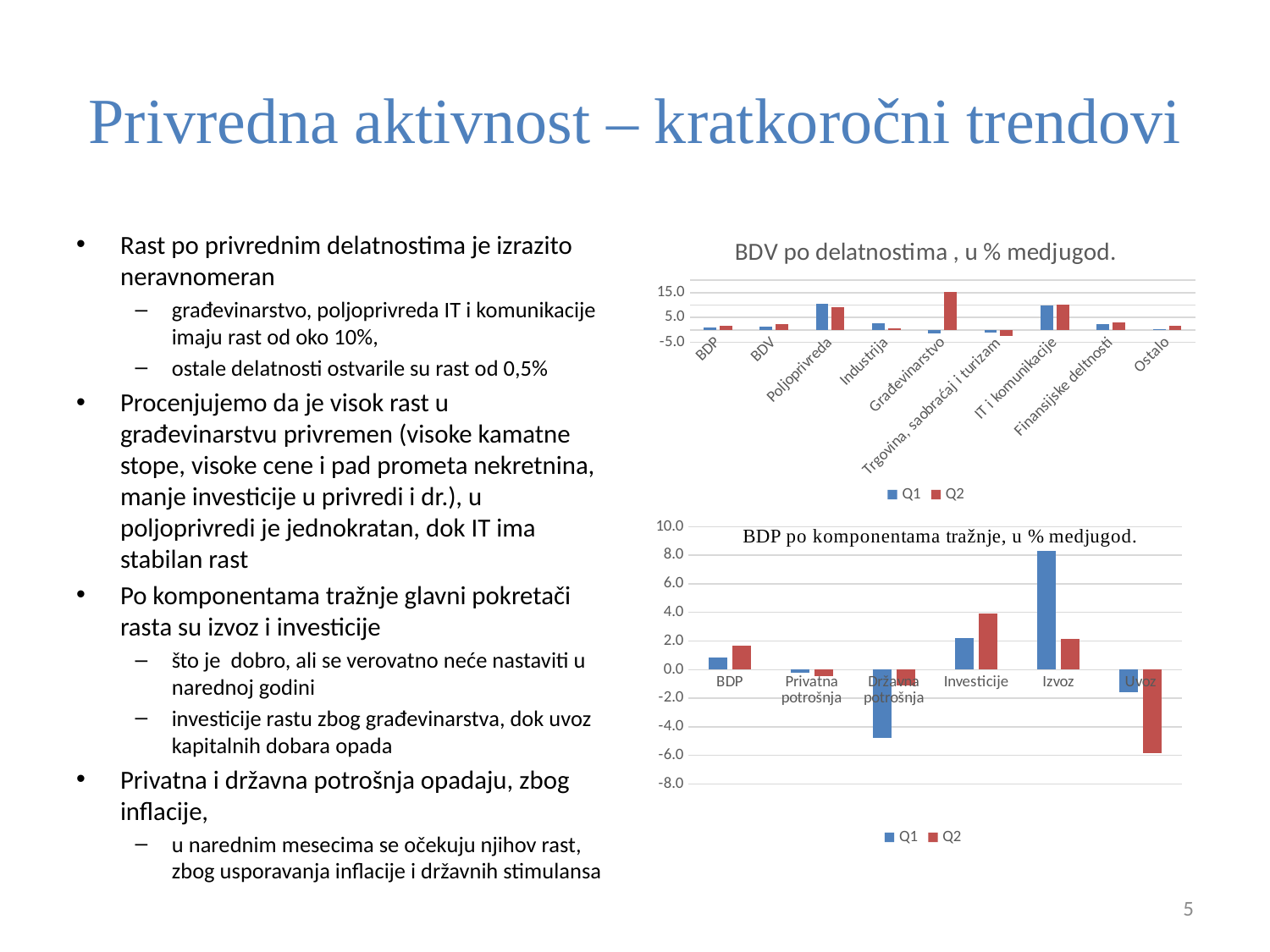
In the 'BDP po komponentama tražnje' chart, which category has the lowest Q2 value? Uvoz In the 'BDP po komponentama tražnje' chart, which is larger for Izvoz, the Q1 value or the Q2 value? Q1 In the 'BDP po komponentama tražnje' chart, is the Q2 value for Investicije greater or less than 2.0? greater How many series does the legend of the 'BDP po komponentama tražnje' chart list? 2 In the 'BDV po delatnostima' chart, which category has the highest Q2 value? Građevinarstvo In the 'BDP po komponentama tražnje' chart, which category has the highest Q1 value? Izvoz How many categories are shown on the x axis of the 'BDP po komponentama tražnje' chart? 6 What kind of chart is the 'BDP po komponentama tražnje' chart at the bottom right? bar chart In the 'BDP po komponentama tražnje' chart, is the Q1 value for Izvoz greater or less than 6.0? greater How many categories are shown on the x axis of the 'BDV po delatnostima' chart? 9 What are the two legend entries of the 'BDV po delatnostima' chart? Q1 and Q2 In the 'BDP po komponentama tražnje' chart, is the Q2 value for Uvoz greater or less than -4.0? less